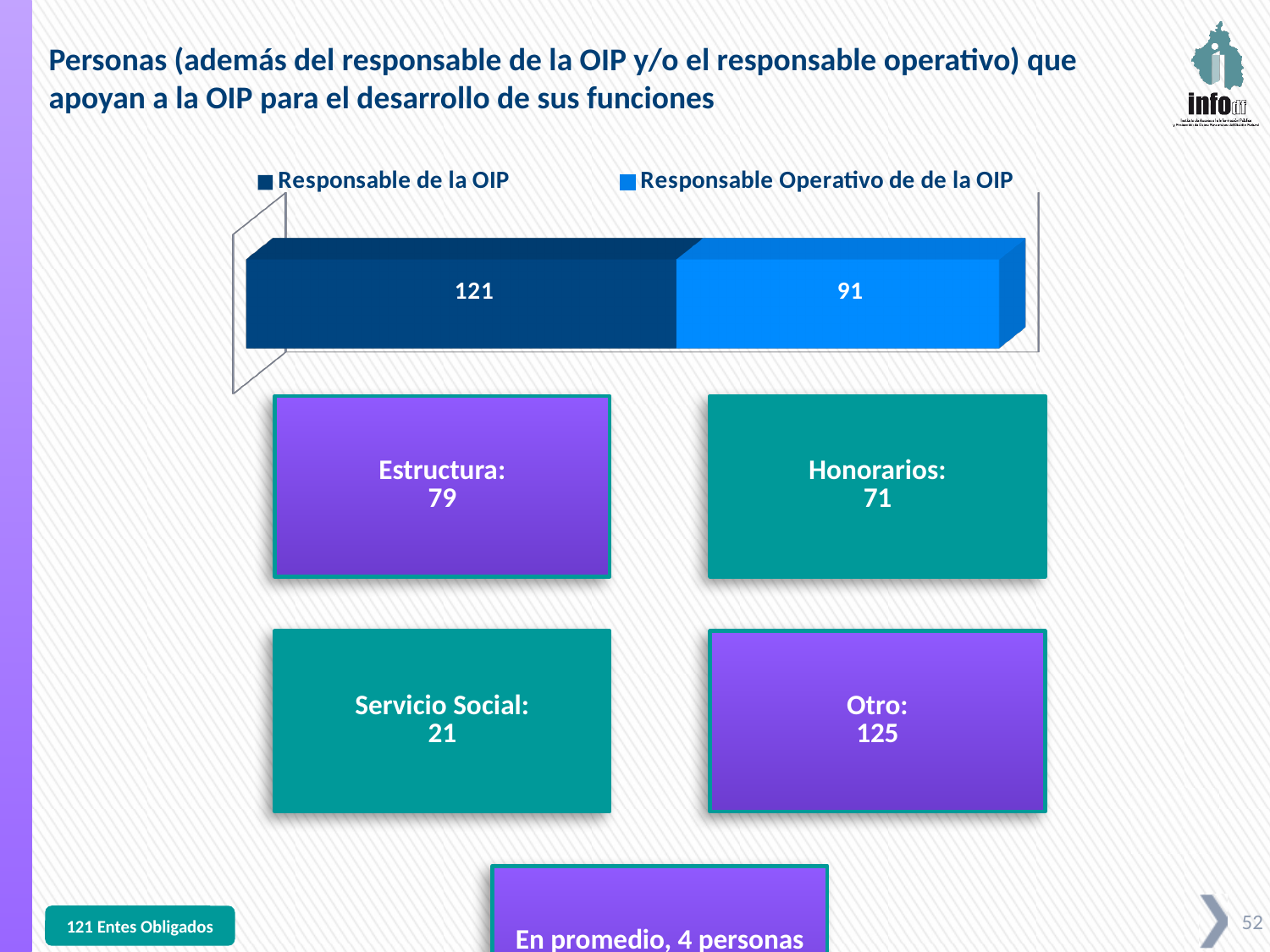
What colour represents the Responsable de la OIP series in the bar chart? Dark blue What is the difference between the Responsable de la OIP value and the Responsable Operativo de de la OIP value in the bar chart? 30 What is the total of the stacked bar in the chart? 212 How many series does the legend of the bar chart list? 2 What is the value for the Responsable de la OIP series in the stacked bar chart? 121 What is the value for the Responsable Operativo de de la OIP series in the stacked bar chart? 91 What are the two legend entries of the bar chart? Responsable de la OIP; Responsable Operativo de de la OIP How many bars are plotted in the stacked bar chart? 1 Which series has the lowest value in the stacked bar chart? Responsable Operativo de de la OIP What kind of chart is shown at the top of the slide? Stacked bar chart Which series has the larger value in the stacked bar chart, Responsable de la OIP or Responsable Operativo de de la OIP? Responsable de la OIP Which series has the highest value in the stacked bar chart? Responsable de la OIP